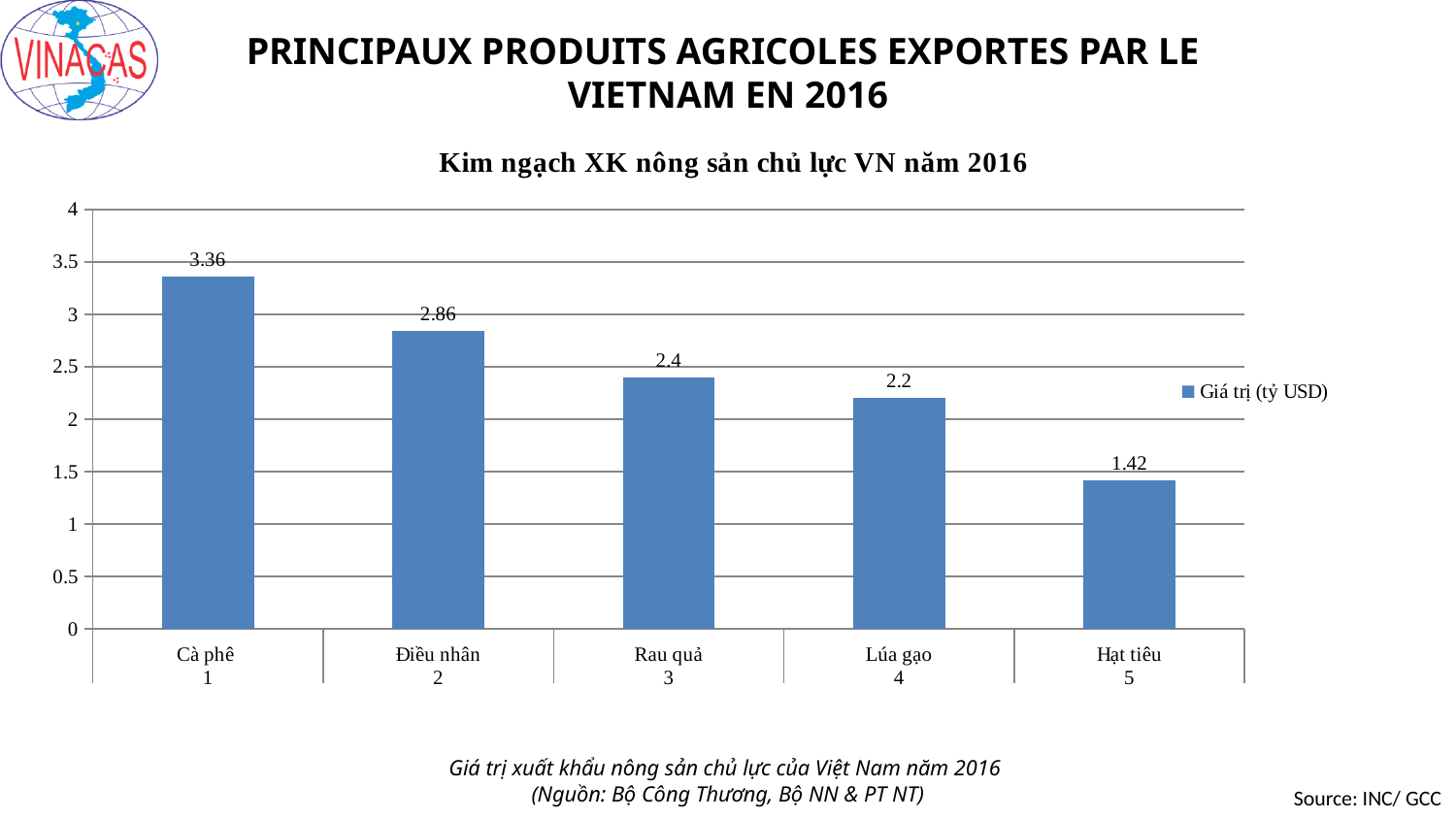
Which category has the lowest value? Hạt tiêu What is the value for Hạt tiêu? 1.42 What is the value for Điều nhân? 2.86 What is the value for Cà phê? 3.36 What is the difference between the values for Cà phê and Điều nhân? 0.5 What is the difference between the values for Rau quả and Lúa gạo? 0.2 What is the legend entry for the series? Giá trị (tỷ USD) Which is larger, the value for Rau quả or the value for Hạt tiêu? Rau quả How many categories are shown on the chart? 5 How many series does the legend list? 1 Which category has the highest value? Cà phê What kind of chart is shown? Bar chart